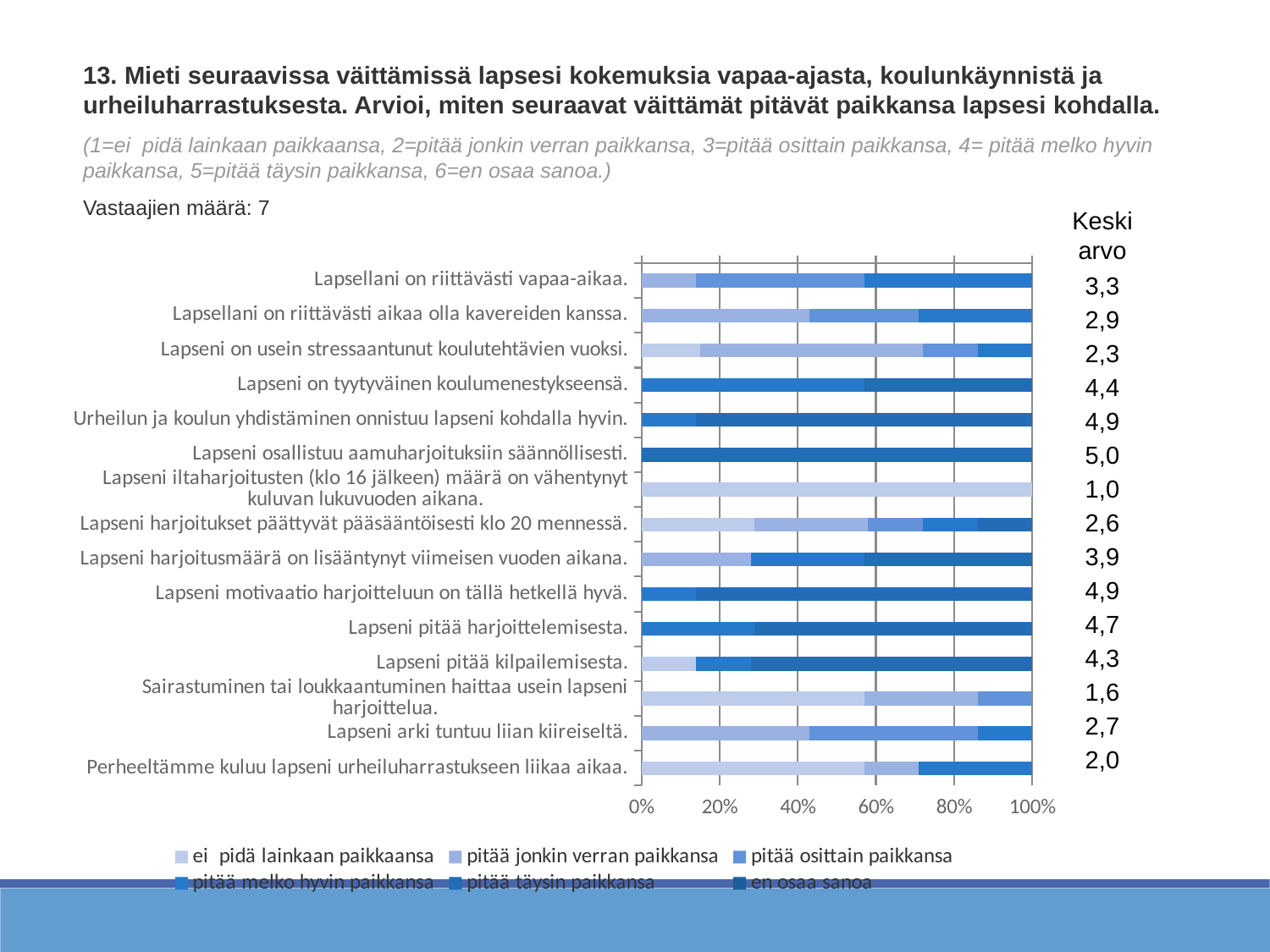
Which has a higher mean value: 'Lapseni on tyytyväinen koulumenestykseensä.' or 'Urheilun ja koulun yhdistäminen onnistuu lapseni kohdalla hyvin.'? Urheilun ja koulun yhdistäminen onnistuu lapseni kohdalla hyvin. Is the 'ei pidä lainkaan paikkaansa' share for 'Lapsellani on riittävästi vapaa-aikaa.' greater or less than 20%? less What is the mean value (Keski arvo) for 'Lapsellani on riittävästi vapaa-aikaa.'? 3,3 What is the mean value (Keski arvo) for 'Lapseni on tyytyväinen koulumenestykseensä.'? 4,4 What is the mean value (Keski arvo) for 'Lapseni pitää kilpailemisesta.'? 4,3 What kind of chart is shown on the slide? Stacked bar chart Which statement has the highest mean value (Keski arvo)? Lapseni osallistuu aamuharjoituksiin säännöllisesti. How many statements (categories) are plotted in the chart? 15 Which statement has the lowest mean value (Keski arvo)? Lapseni iltaharjoitusten (klo 16 jälkeen) määrä on vähentynyt kuluvan lukuvuoden aikana. How many series does the chart legend list? 6 What is the difference between the highest mean value (5,0) and the lowest mean value (1,0)? 4,0 What is the first entry in the chart legend? ei pidä lainkaan paikkaansa